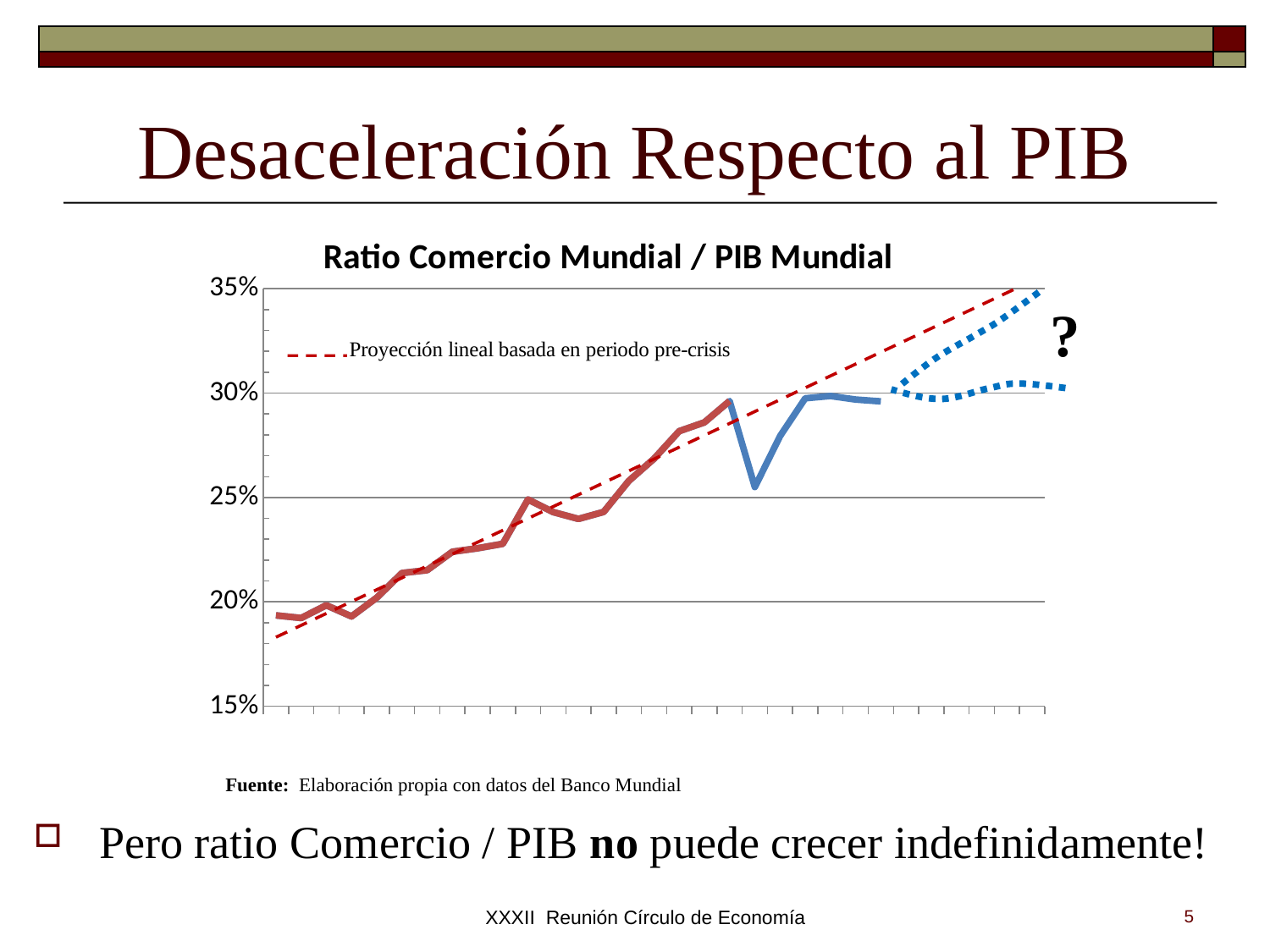
Is the value at the left-most point of the solid line greater or less than 20%? less What type of chart is shown on the slide? line chart Is the value at the left-most point of the solid line greater or less than 15%? greater What is the lowest value shown on the vertical axis of the chart? 15% What is the title of the chart? Ratio Comercio Mundial / PIB Mundial Is the highest value reached by the solid line greater or less than 25%? greater Overall, does the solid line in the chart rise or fall from left to right? rise What is the highest value shown on the vertical axis of the chart? 35% What series name does the chart legend show for the dashed red line? Proyección lineal basada en periodo pre-crisis